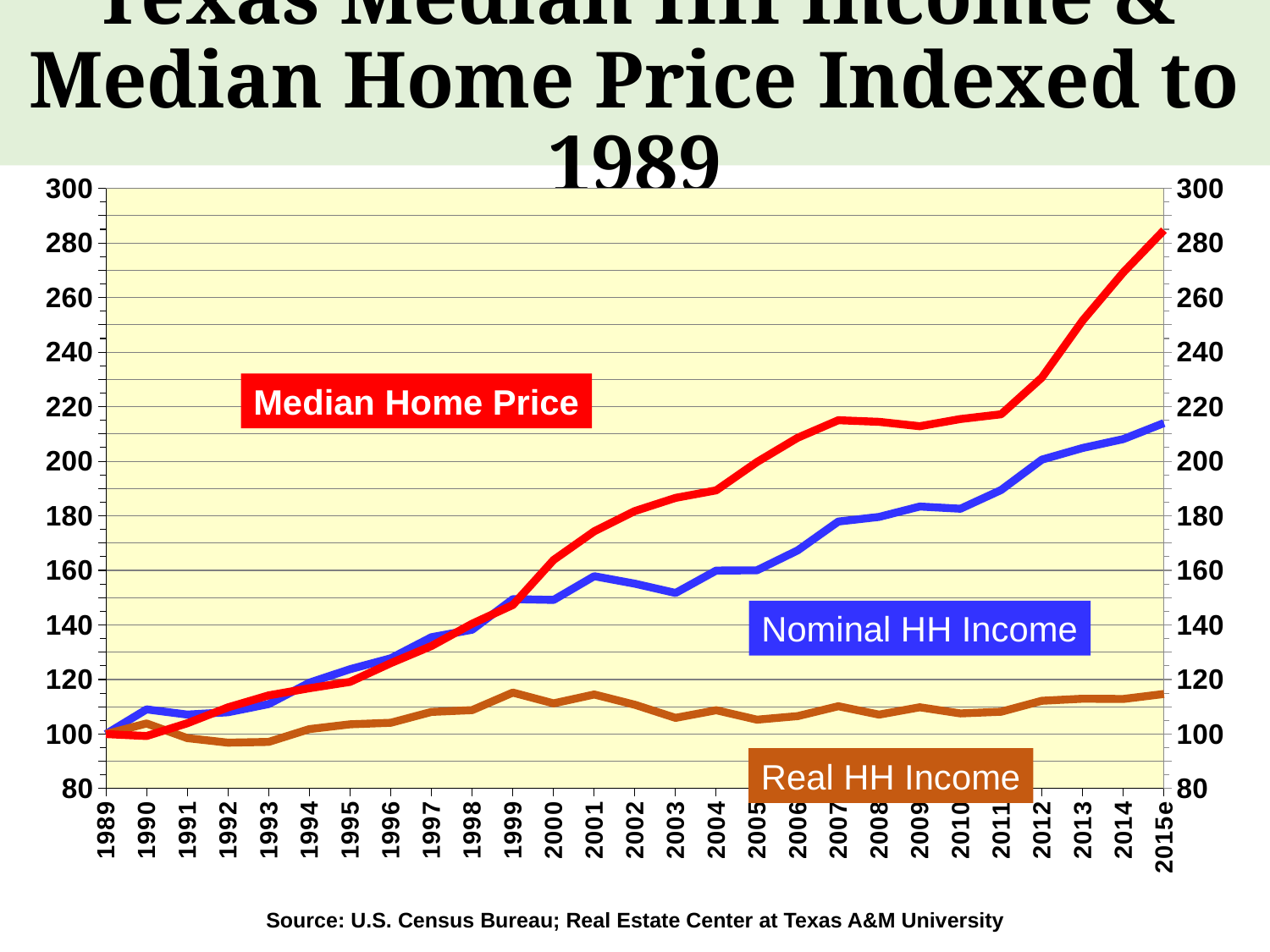
Which series has the highest value in 2015e? Median Home Price What is the indexed value of all three series in 1989? 100 Is the value for Real HH Income in 2015e greater or less than 120? less Is the value for Median Home Price in 2015e greater or less than 260? greater Is the value for Nominal HH Income in 2015e greater or less than 200? greater Which series has the lowest value in 2015e? Real HH Income How many years are labelled along the x axis of the chart? 27 What colour is the Median Home Price line? Red How many series are plotted on the chart? 3 In 1990, which is larger: Nominal HH Income or Median Home Price? Nominal HH Income Does the Median Home Price line rise or fall from 2011 to 2015e? Rise What kind of chart is shown on the slide? Line chart